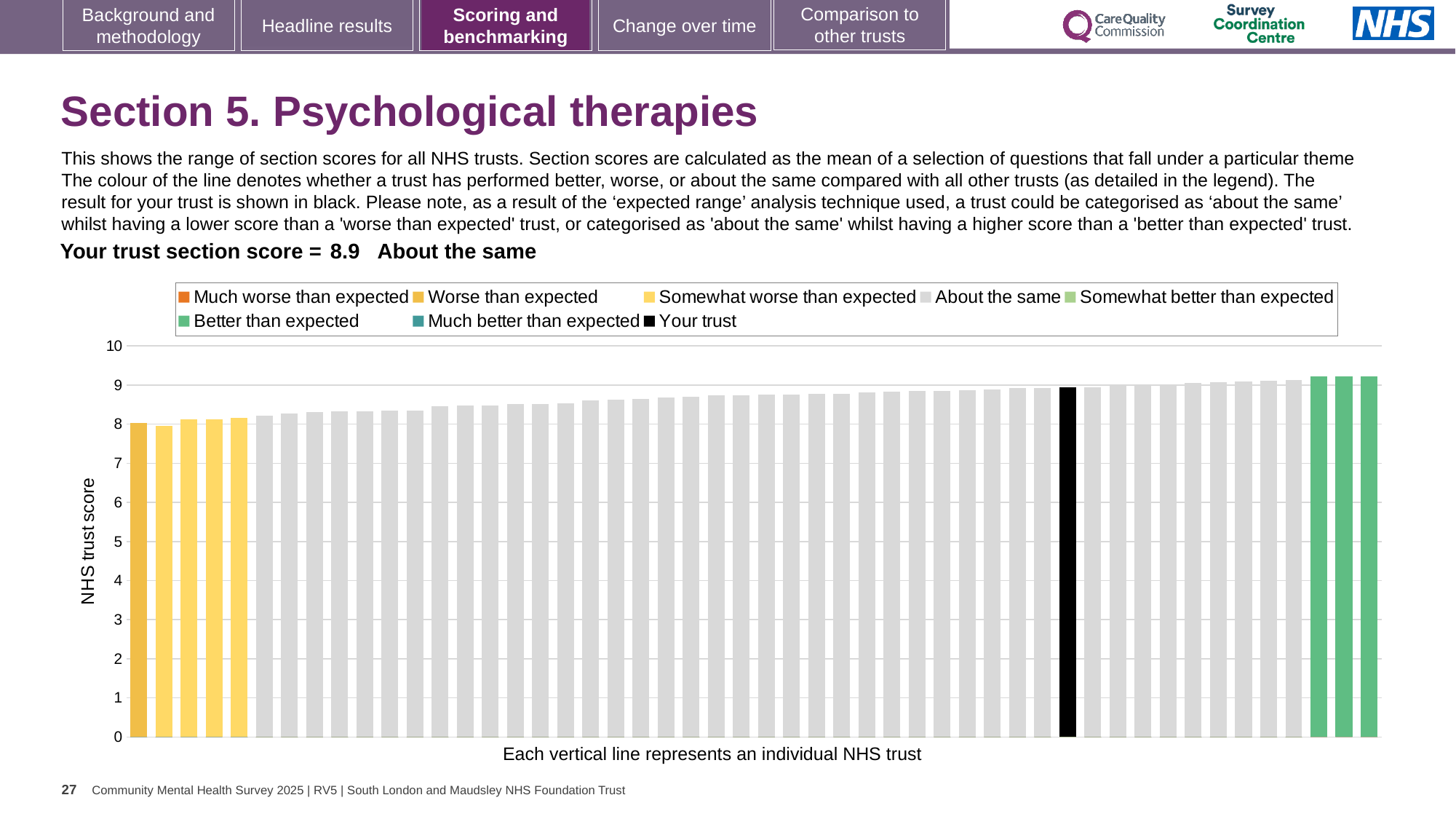
How many bars are coloured green (better than expected)? 3 Is the value of the black 'Your trust' bar greater or less than 8? greater What is the label on the vertical axis of the chart? NHS trust score What colour is the bar representing your trust? black How many entries does the chart legend list? 8 Which category is your trust placed in for this section? About the same Is the value of the rightmost bar greater or less than 9? greater What kind of chart is shown on the slide? bar chart What is the section score for your trust shown on the slide? 8.9 Do the bar values rise or fall from left to right along the x axis? rise Is the value of the leftmost bar greater or less than 9? less Which is larger, the value of the 'Your trust' bar or the value of the leftmost bar? Your trust